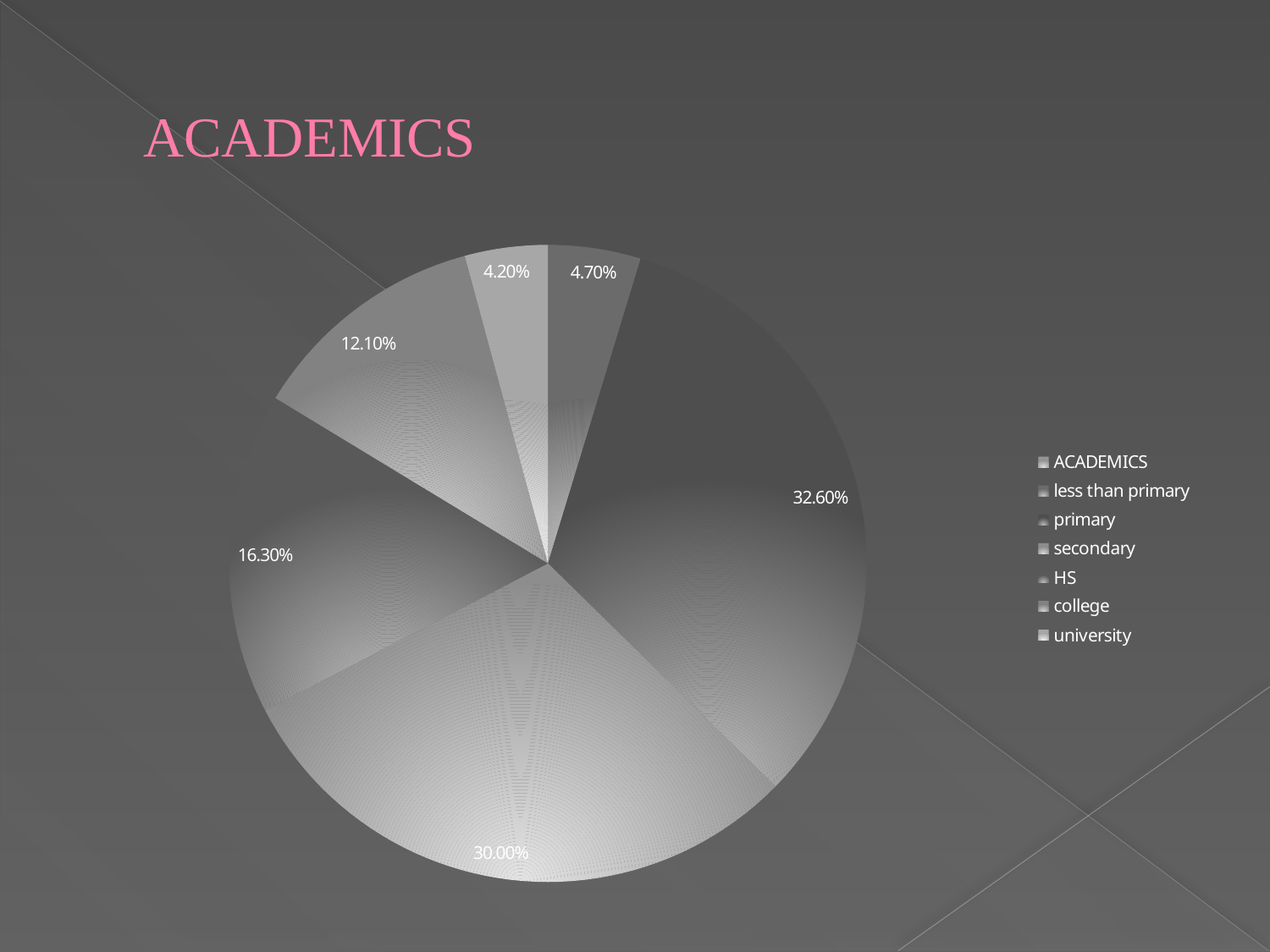
Is the largest slice of the pie chart greater or less than 30%? greater How many labelled slices does the pie chart have? 6 What is the value of the smallest slice of the pie chart? 4.20% How many entries does the chart's legend list? 7 What is the value of the largest slice of the pie chart? 32.60% What is the title of the chart on the slide? ACADEMICS What is the difference between the two largest slices, 32.60% and 30.00%? 2.60% What kind of chart is shown on the slide? pie chart What is the difference between the 16.30% slice and the 12.10% slice? 4.20% What is the combined share of the 32.60% and 30.00% slices? 62.60% Which is larger, the 4.70% slice or the 4.20% slice? 4.70% What is the last entry listed in the chart's legend? university